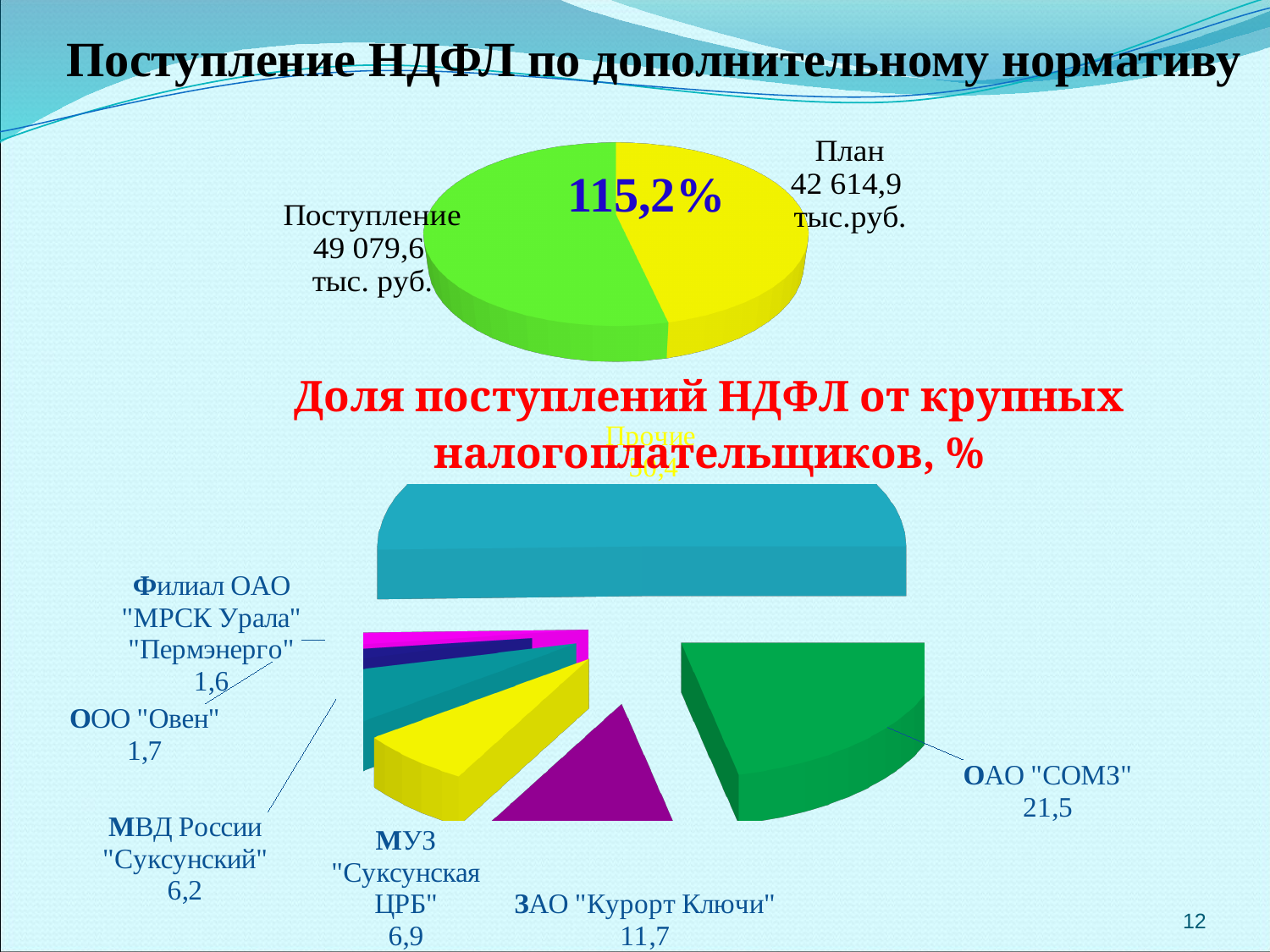
In the bottom chart 'Доля поступлений НДФЛ от крупных налогоплательщиков, %', what is the difference between the shares of ОАО "СОМЗ" and ЗАО "Курорт Ключи"? 9,8 In the top pie chart, which is larger, План or Поступление? Поступление In the bottom chart 'Доля поступлений НДФЛ от крупных налогоплательщиков, %', what is the share for ОАО "СОМЗ"? 21,5 In the top pie chart, what is the value for Поступление? 49 079,6 тыс. руб. In the top pie chart, what percentage is printed in the centre of the chart? 115,2% In the bottom chart 'Доля поступлений НДФЛ от крупных налогоплательщиков, %', what is the share for МВД России "Суксунский"? 6,2 In the bottom chart 'Доля поступлений НДФЛ от крупных налогоплательщиков, %', which has the larger share, МУЗ "Суксунская ЦРБ" or МВД России "Суксунский"? МУЗ "Суксунская ЦРБ" In the top pie chart, what is the difference between Поступление and План in тыс. руб.? 6 464,7 In the bottom chart 'Доля поступлений НДФЛ от крупных налогоплательщиков, %', what is the share for ЗАО "Курорт Ключи"? 11,7 In the bottom chart 'Доля поступлений НДФЛ от крупных налогоплательщиков, %', which of the named taxpayers has the highest share? ОАО "СОМЗ" In the top pie chart, what is the value for План? 42 614,9 тыс.руб. What kind of chart is the top chart on the slide? Pie chart